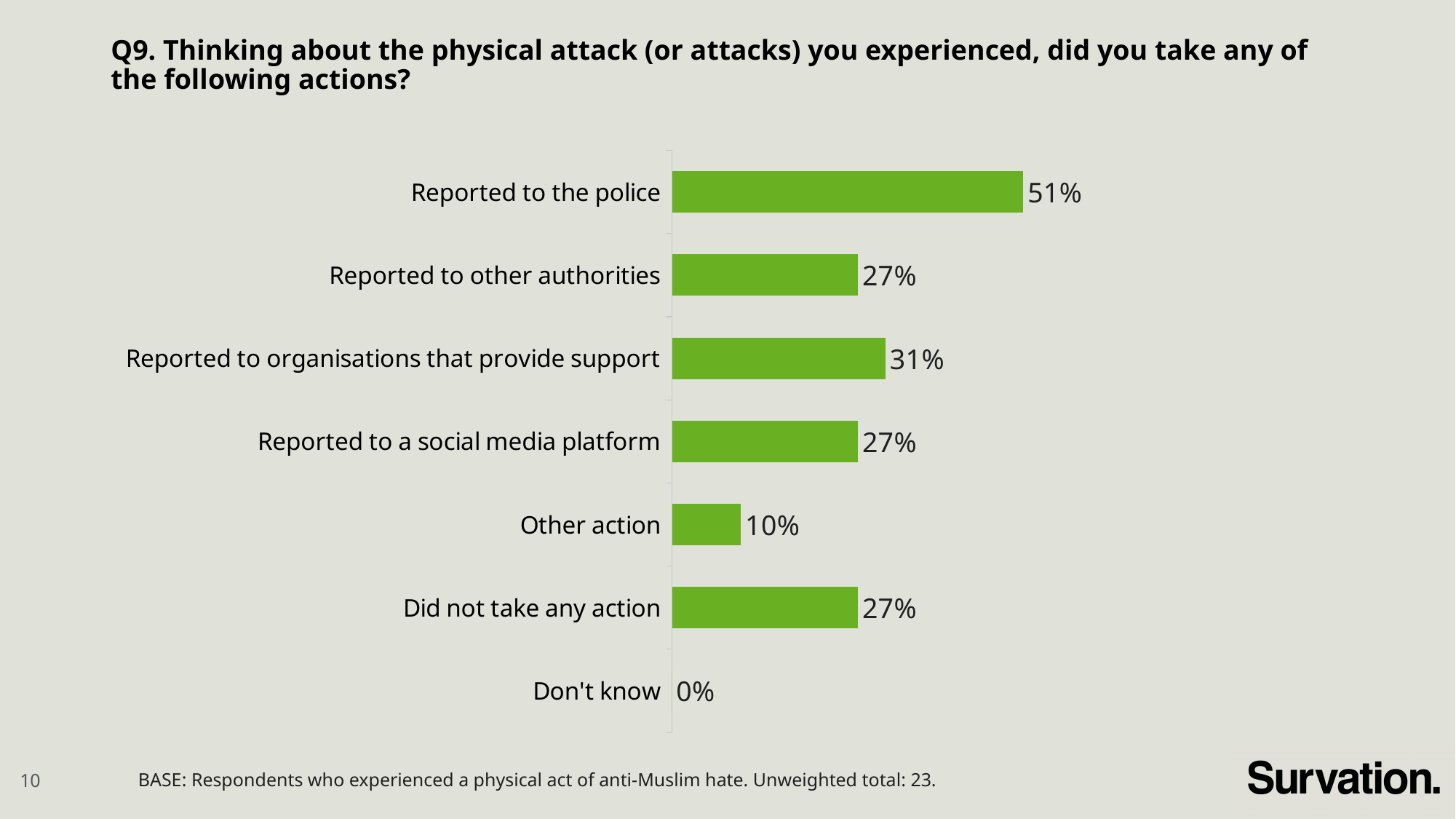
What is the unweighted total of respondents stated in the base note? 23 How many categories are shown in the chart? 7 What percentage of respondents reported the attack to the police? 51% Which category has the lowest value? Don't know What is the difference between 'Reported to the police' and 'Reported to other authorities'? 24 percentage points What percentage of respondents chose 'Other action'? 10% What is the value for 'Reported to organisations that provide support'? 31% What is the difference between 'Reported to organisations that provide support' and 'Other action'? 21 percentage points Which action has the highest percentage? Reported to the police Which is larger: 'Reported to organisations that provide support' or 'Reported to a social media platform'? Reported to organisations that provide support What type of chart is shown on the slide? Bar chart What is the value for 'Did not take any action'? 27%